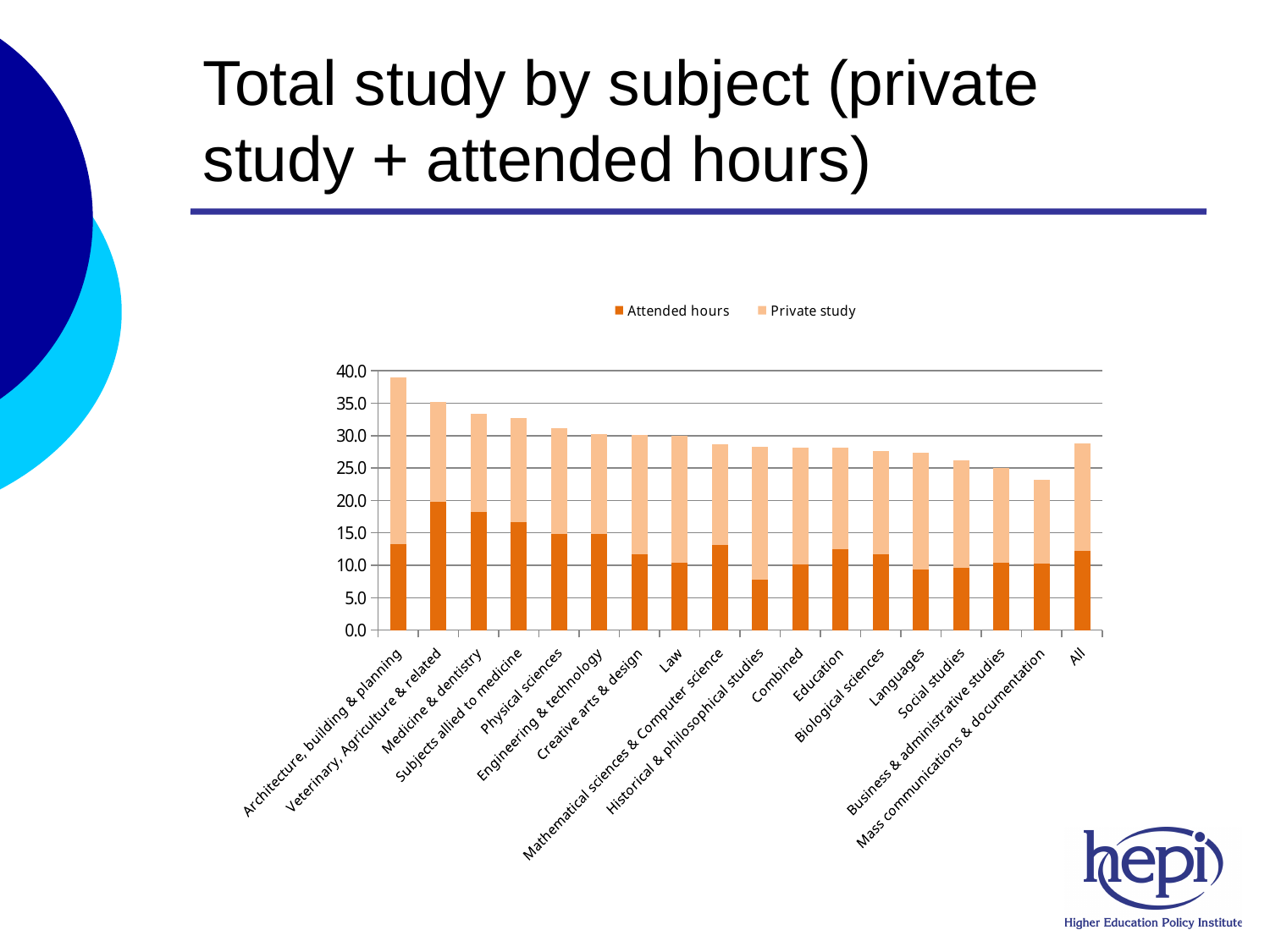
What are the two series named in the legend? Attended hours and Private study Which subject has the lowest total study hours? Mass communications & documentation How many series does the legend list? 2 Which has more attended hours: Veterinary, Agriculture & related or Architecture, building & planning? Veterinary, Agriculture & related Which subject has the lowest attended hours? Historical & philosophical studies Excluding the final 'All' bar, do the total study hours rise or fall from left to right across the subjects? Fall Which subject has the highest total study hours? Architecture, building & planning What kind of chart is shown on the slide? Stacked bar chart How many subject categories are plotted along the x axis? 18 Is the total study value for Mass communications & documentation greater or less than 25.0? less Which subject has the highest attended hours? Veterinary, Agriculture & related Is the total study value for Architecture, building & planning greater or less than 35.0? greater